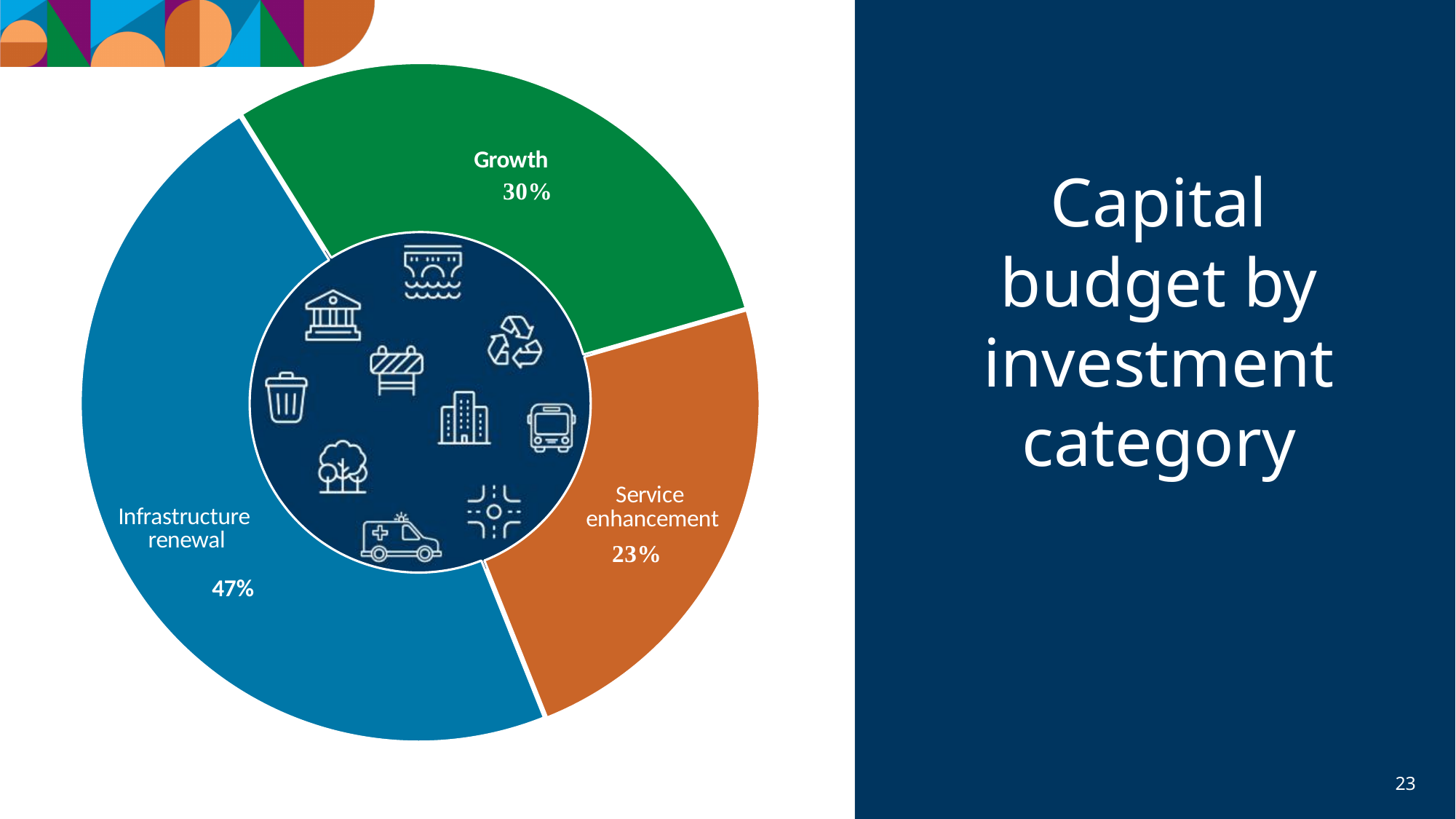
Which investment category has the largest share of the capital budget? Infrastructure renewal How many investment categories are shown in the chart? 3 What share of the capital budget goes to Infrastructure renewal? 47% What kind of chart is used to show the capital budget by investment category? Doughnut (pie) chart How many percentage points larger is the Infrastructure renewal share than the Growth share? 17 What colour is the Infrastructure renewal segment? Blue What is the combined share of Growth and Service enhancement? 53% How many percentage points larger is the Growth share than the Service enhancement share? 7 Which investment category has the smallest share of the capital budget? Service enhancement Which is larger, the share for Growth or the share for Service enhancement? Growth What share of the capital budget goes to Service enhancement? 23% What share of the capital budget goes to Growth? 30%